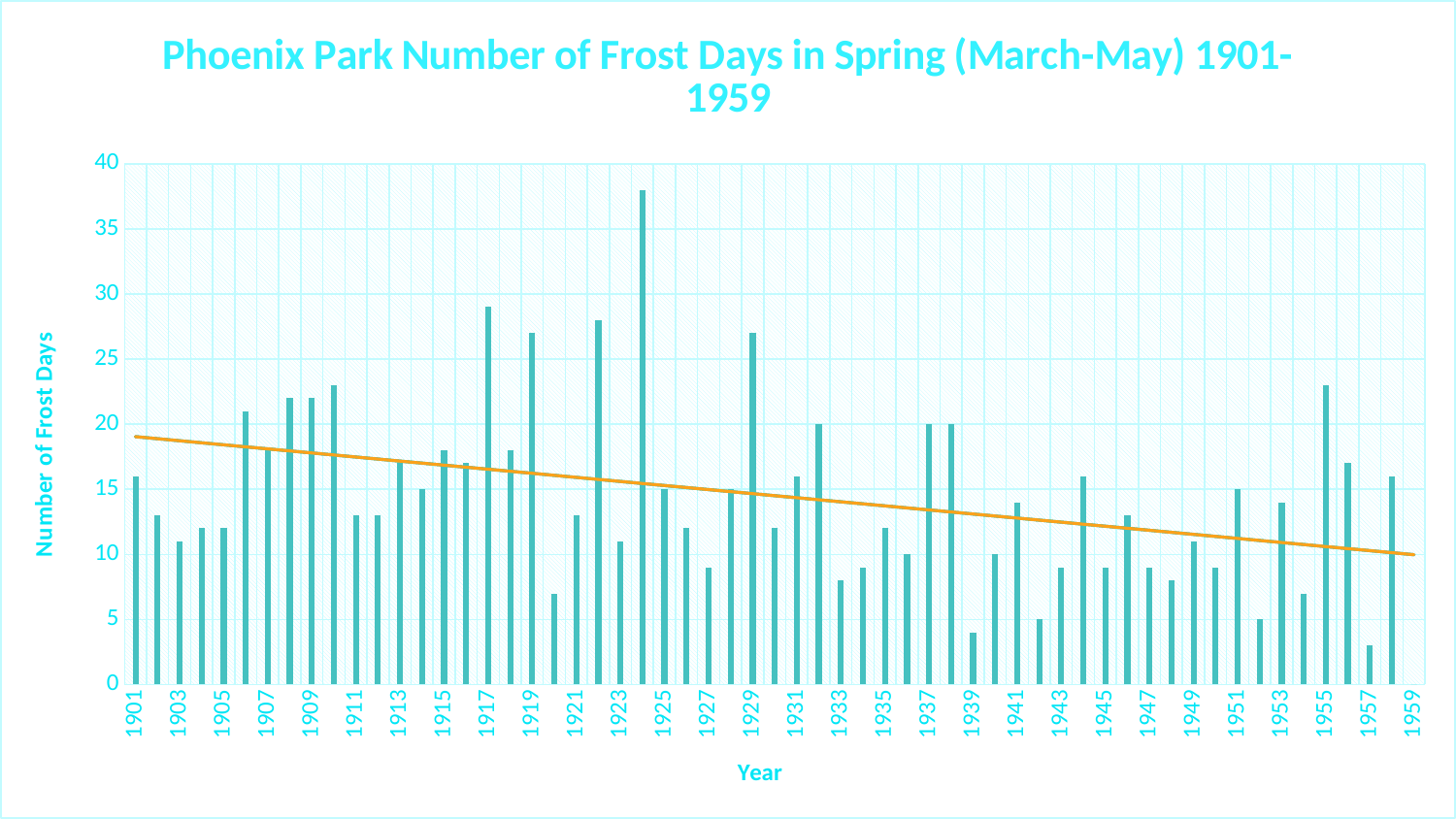
Is the value for 1929 greater or less than 25? greater Is the value for 1924 greater or less than 35? greater Does the trend line show the number of frost days rising or falling from 1901 to 1959? falling What kind of chart is shown on the slide? bar chart Which year has more frost days, 1955 or 1954? 1955 Which year has more frost days, 1906 or 1903? 1906 Which year has the highest number of frost days in spring? 1924 Is the value for 1920 greater or less than 10? less What is the label on the vertical axis? Number of Frost Days